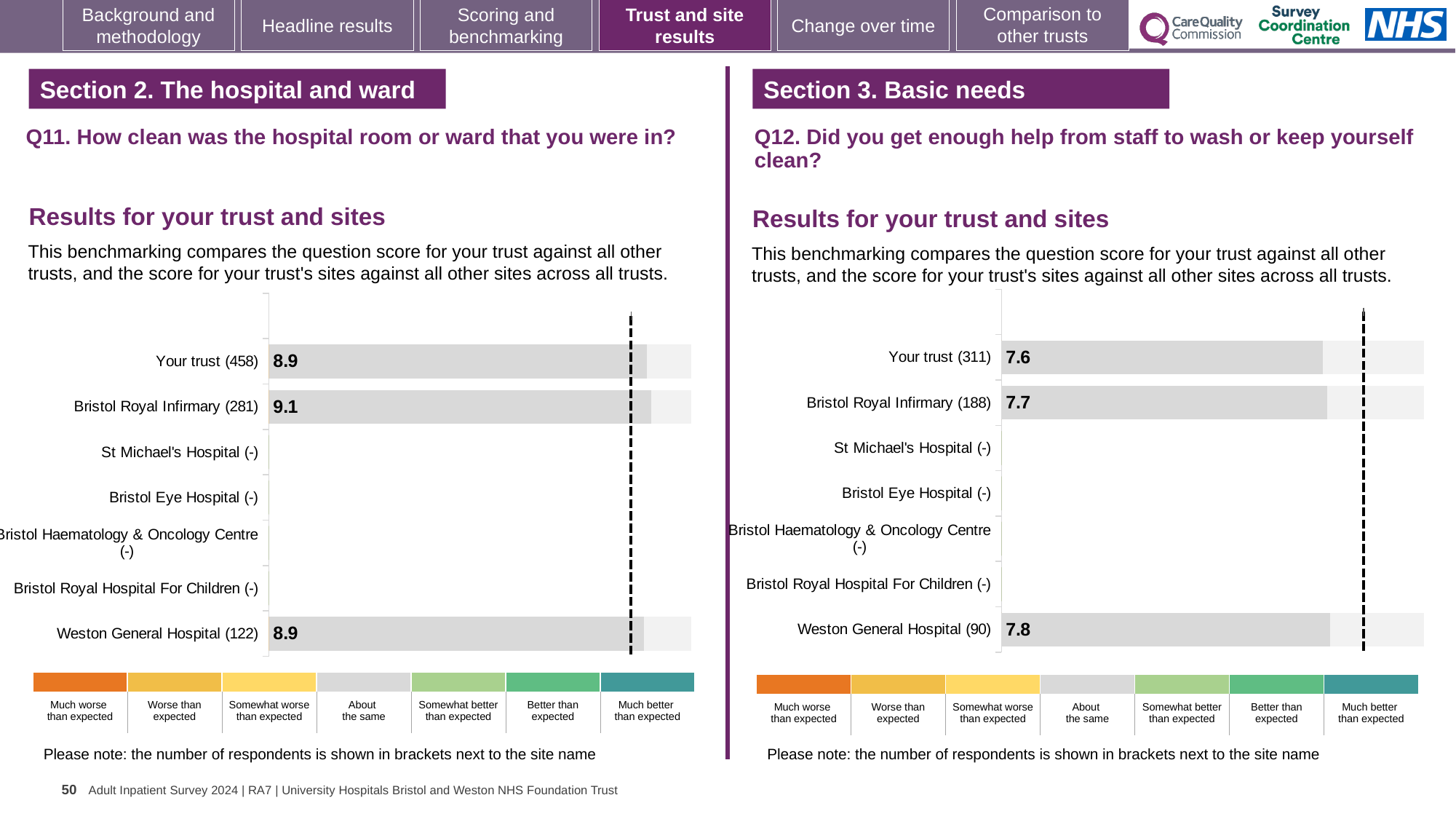
How many site/trust categories are listed on the y axis of the Q11 chart (left)? 7 In the Q11 chart (left), what is the score for Bristol Royal Infirmary? 9.1 What kind of chart is used for the Q12 results (right)? Bar chart In the Q12 chart (right), what is the score for Your trust? 7.6 In the Q11 chart (left), what is the score for Weston General Hospital? 8.9 In the Q11 chart (left), what is the difference between the Bristol Royal Infirmary score and the Your trust score? 0.2 In the Q11 chart (left), how many respondents are shown in brackets for Your trust? 458 In the Q11 chart (left), what is the score for Your trust? 8.9 In the Q12 chart (right), which site has the highest score? Weston General Hospital In the Q12 chart (right), what is the score for Weston General Hospital? 7.8 In the Q12 chart (right), which is larger: the score for Bristol Royal Infirmary or the score for Your trust? Bristol Royal Infirmary In the Q12 chart (right), what is the difference between the Weston General Hospital score and the Your trust score? 0.2